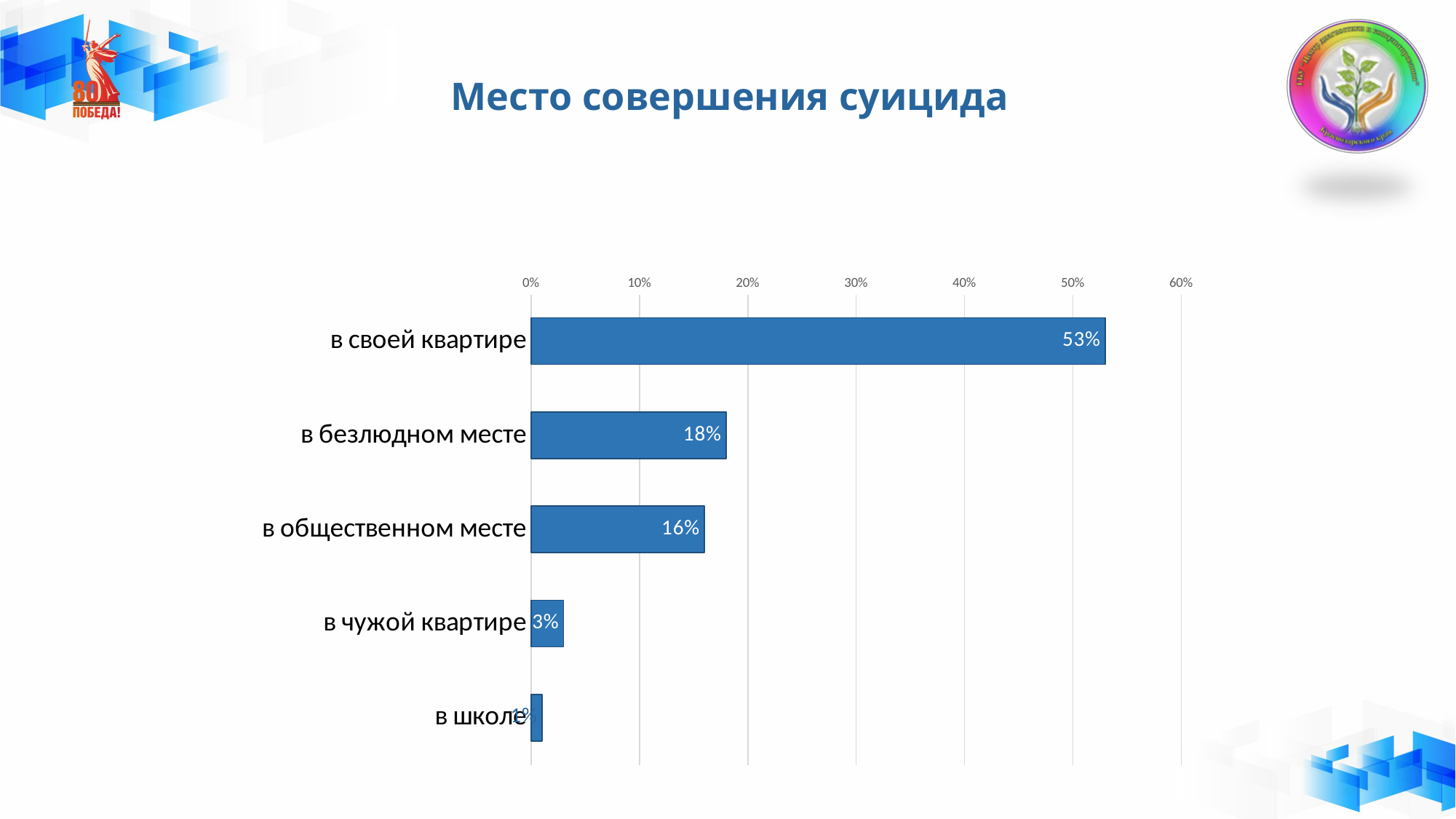
Which category has the lowest value? в школе Is the value for "в своей квартире" greater or less than 50%? greater Which is larger: the value for "в общественном месте" or the value for "в чужой квартире"? в общественном месте Which category has the highest value? в своей квартире What is the difference between the values for "в безлюдном месте" and "в общественном месте"? 2% What is the value for "в безлюдном месте"? 18% What is the difference between the values for "в своей квартире" and "в безлюдном месте"? 35% What is the value for "в своей квартире"? 53% What is the value for "в чужой квартире"? 3% What type of chart is shown on the slide? bar chart What is the value for "в общественном месте"? 16% How many categories are shown in the chart? 5